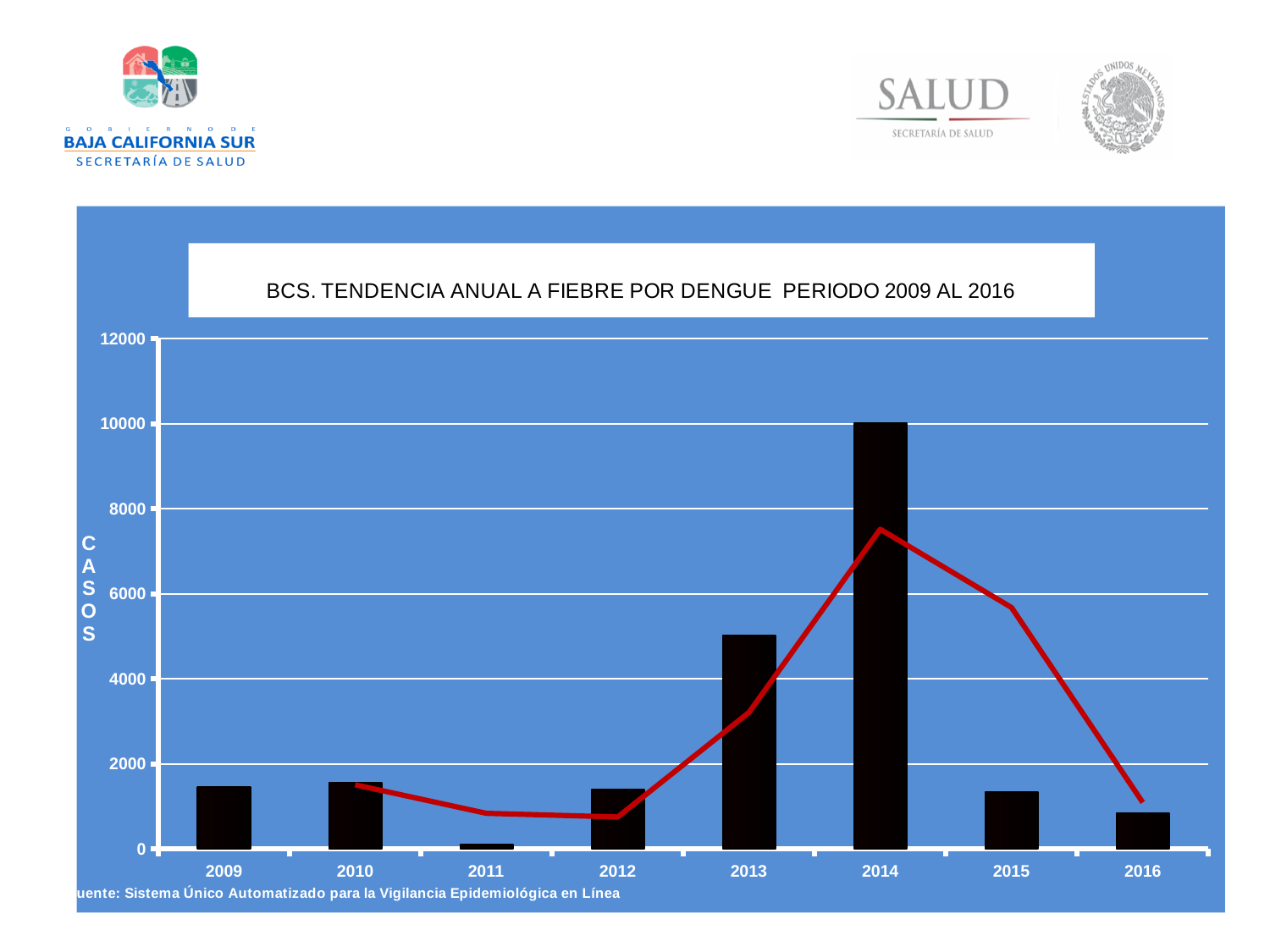
Is the value for 2014 greater or less than 8000? greater What is the title of the chart? BCS. TENDENCIA ANUAL A FIEBRE POR DENGUE PERIODO 2009 AL 2016 Which year has the larger bar, 2013 or 2015? 2013 Is the value for 2016 greater or less than 2000? less What kind of chart is shown on the slide? bar chart with a line Do the bar values rise or fall from 2014 to 2016? fall How many years are shown on the x axis of the chart? 8 Is the value for 2013 greater or less than 4000? greater Which year has the lowest bar in the chart? 2011 Which year has the highest bar in the chart? 2014 What label is written on the y axis of the chart? CASOS